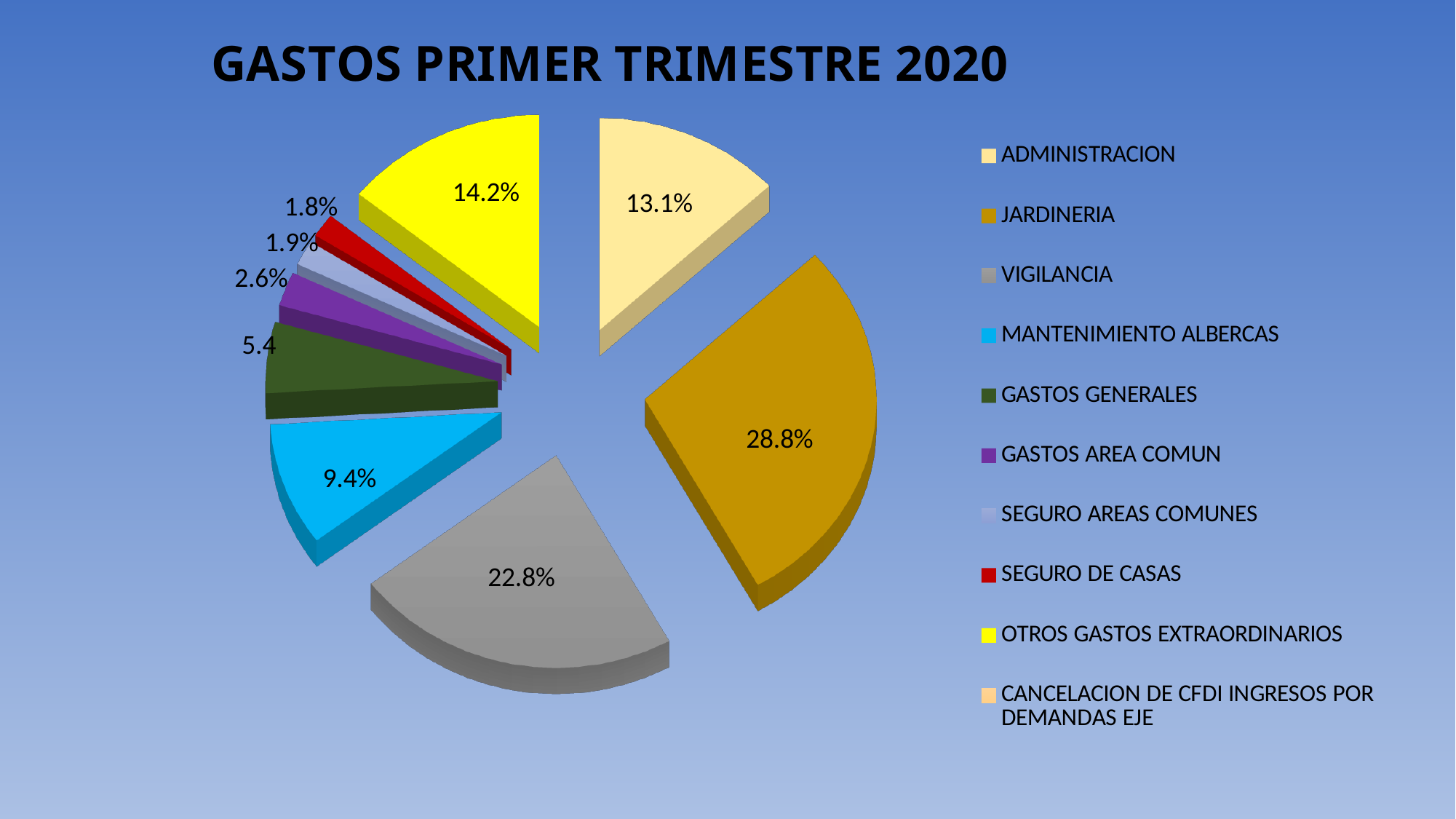
What is the value shown for ADMINISTRACION? 13.1% What type of chart is shown on the slide? Pie chart What is the title of the chart? GASTOS PRIMER TRIMESTRE 2020 What percentage of the pie does JARDINERIA represent? 28.8% Which category has the largest share of the pie? JARDINERIA What is the value shown for MANTENIMIENTO ALBERCAS? 9.4% Which is larger, the share for VIGILANCIA or the share for OTROS GASTOS EXTRAORDINARIOS? VIGILANCIA What is the value shown for OTROS GASTOS EXTRAORDINARIOS? 14.2% How many categories are listed in the legend? 10 What is the value shown for GASTOS GENERALES? 5.4 What is the difference between the shares of JARDINERIA and VIGILANCIA? 6.0% What is the value shown for VIGILANCIA? 22.8%